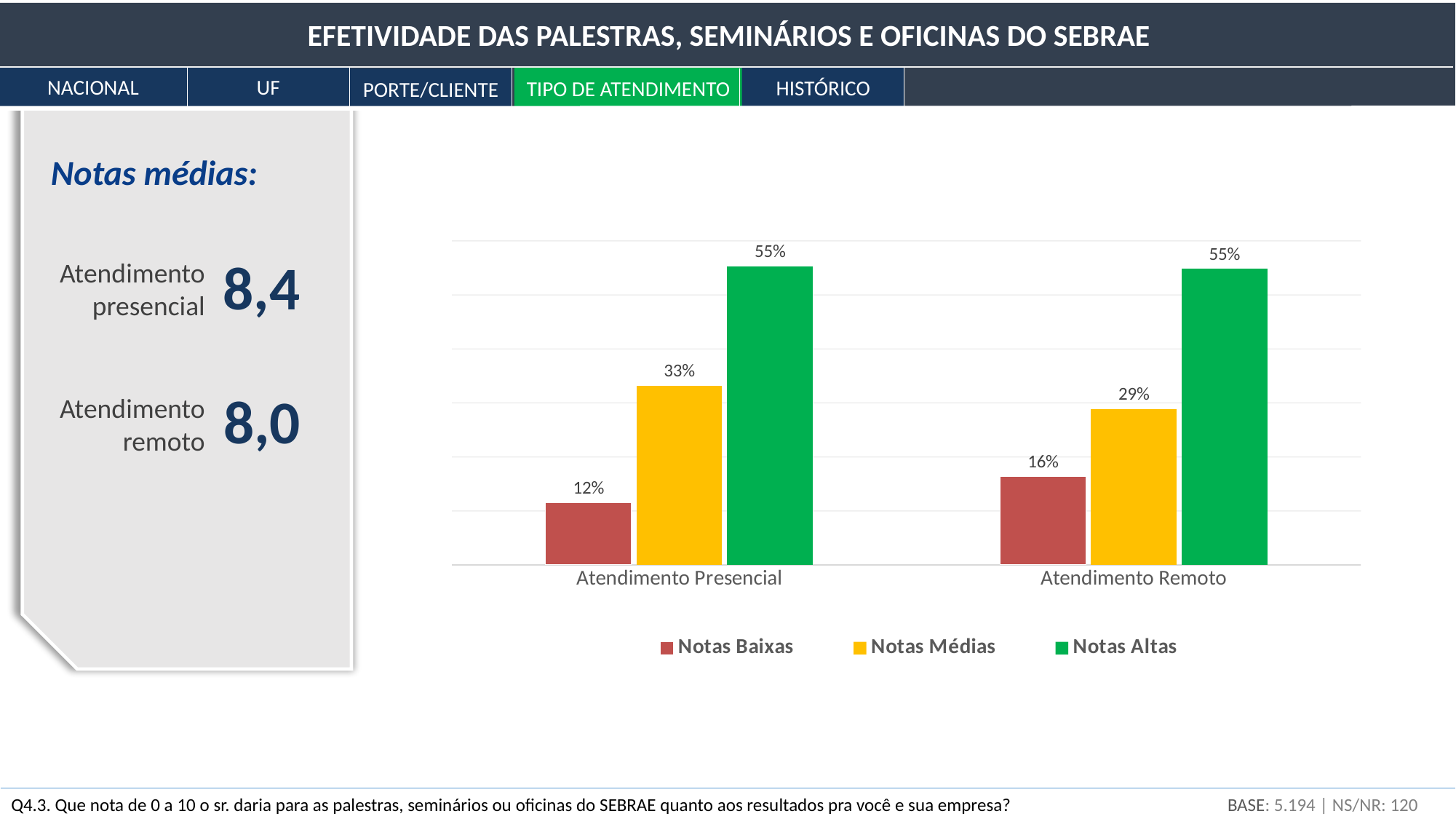
What is the value of Notas Baixas for Atendimento Remoto? 16% Which is larger: Notas Baixas for Atendimento Presencial or Notas Baixas for Atendimento Remoto? Atendimento Remoto What is the value of Notas Médias for Atendimento Remoto? 29% What colour represents Notas Altas in the chart? Green What kind of chart is shown on the slide? Bar chart What is the value of Notas Altas for Atendimento Presencial? 55% Which series has the lowest value for Atendimento Presencial? Notas Baixas What is the value of Notas Baixas for Atendimento Presencial? 12% Which series has the highest value for Atendimento Remoto? Notas Altas How many categories are shown on the x axis? 2 How many series does the legend list? 3 What is the difference between Notas Médias for Atendimento Presencial and Atendimento Remoto? 4%